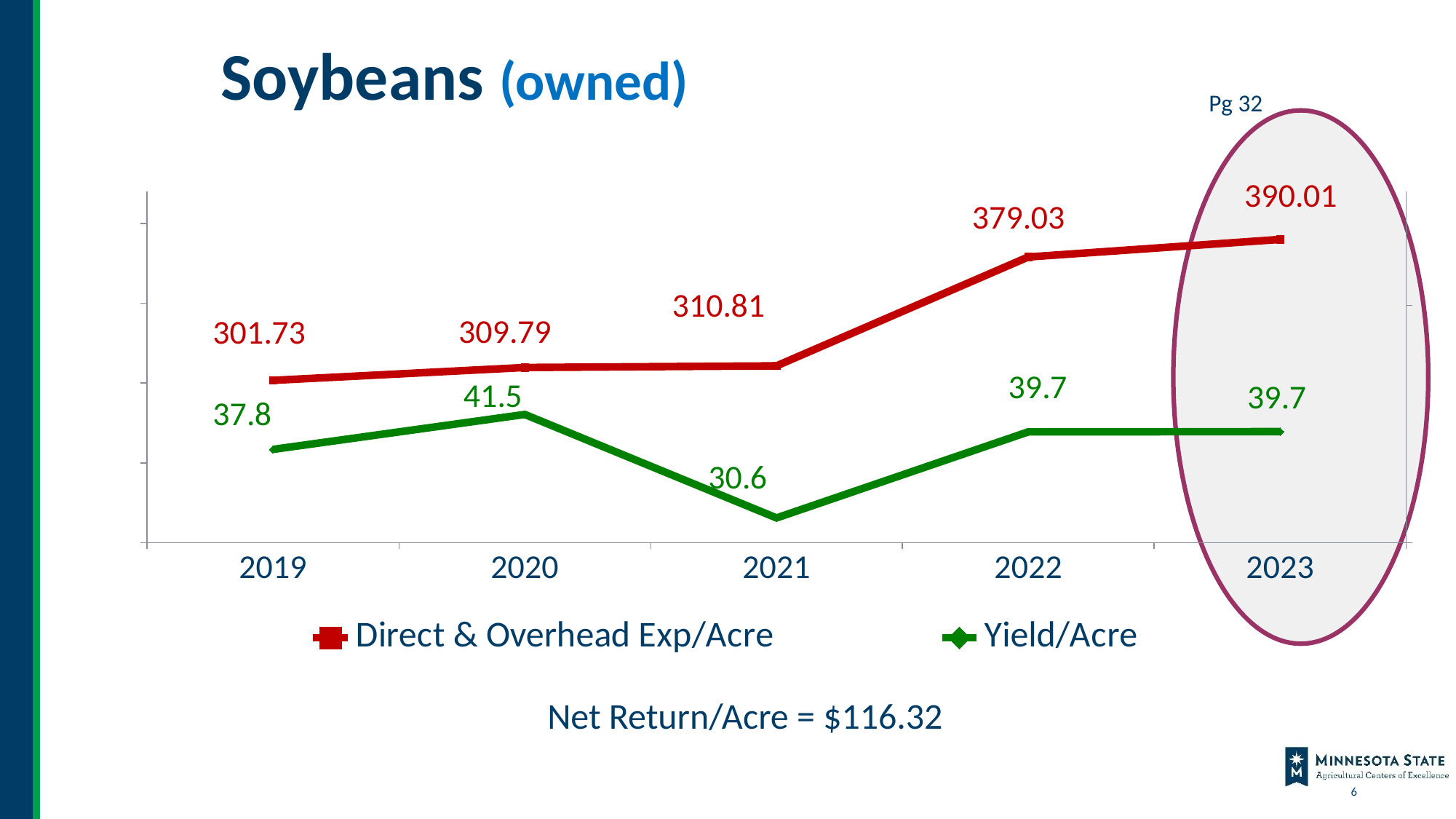
What is the Yield/Acre value for 2021? 30.6 How many years are shown on the x axis? 5 What is the Direct & Overhead Exp/Acre value for 2023? 390.01 Which year has the higher Direct & Overhead Exp/Acre, 2020 or 2021? 2021 In which year is Yield/Acre highest? 2020 What is the difference in Yield/Acre between 2020 and 2021? 10.9 What kind of chart is shown on the slide? Line chart What is the Direct & Overhead Exp/Acre value for 2019? 301.73 How many series does the legend list? 2 In which year is Yield/Acre lowest? 2021 What is the difference in Direct & Overhead Exp/Acre between 2022 and 2021? 68.22 In which year is Direct & Overhead Exp/Acre lowest? 2019